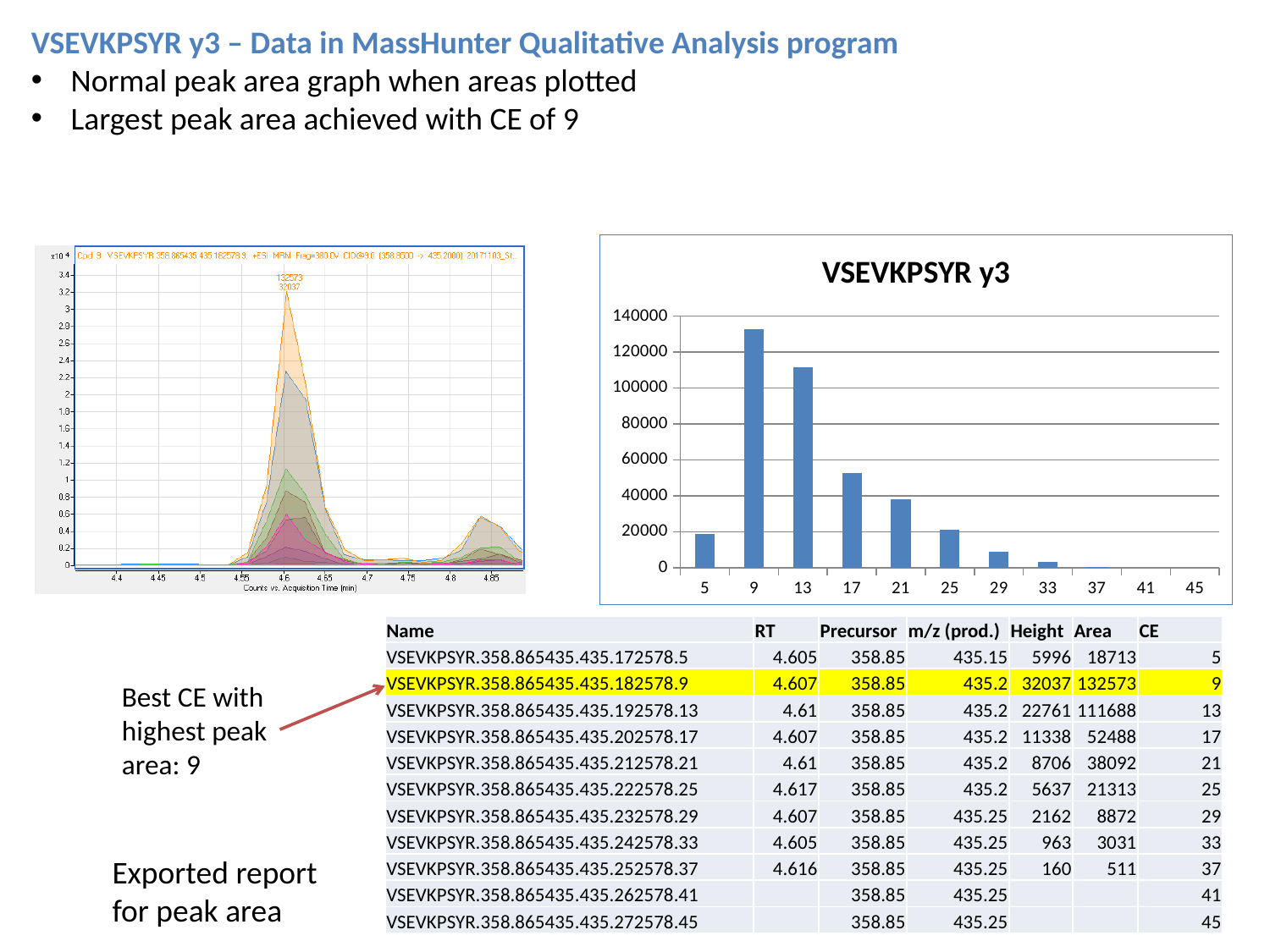
In the chart titled "VSEVKPSYR y3", which has the larger value, 13 or 17? 13 What is the title of the bar chart on the right side of the slide? VSEVKPSYR y3 In the chart titled "VSEVKPSYR y3", is the value for 9 greater or less than 120000? greater In the chart titled "VSEVKPSYR y3", is the value for 21 greater or less than 40000? less In the chart titled "VSEVKPSYR y3", do the values rise or fall from category 9 to category 37? fall In the chart titled "VSEVKPSYR y3", which CE category has the highest bar? 9 In the chart titled "VSEVKPSYR y3", is the value for 17 greater or less than 60000? less How many categories are shown on the x axis of the chart titled "VSEVKPSYR y3"? 11 In the chart titled "VSEVKPSYR y3", which has the larger value, 5 or 21? 21 What kind of chart is the chart titled "VSEVKPSYR y3"? bar chart